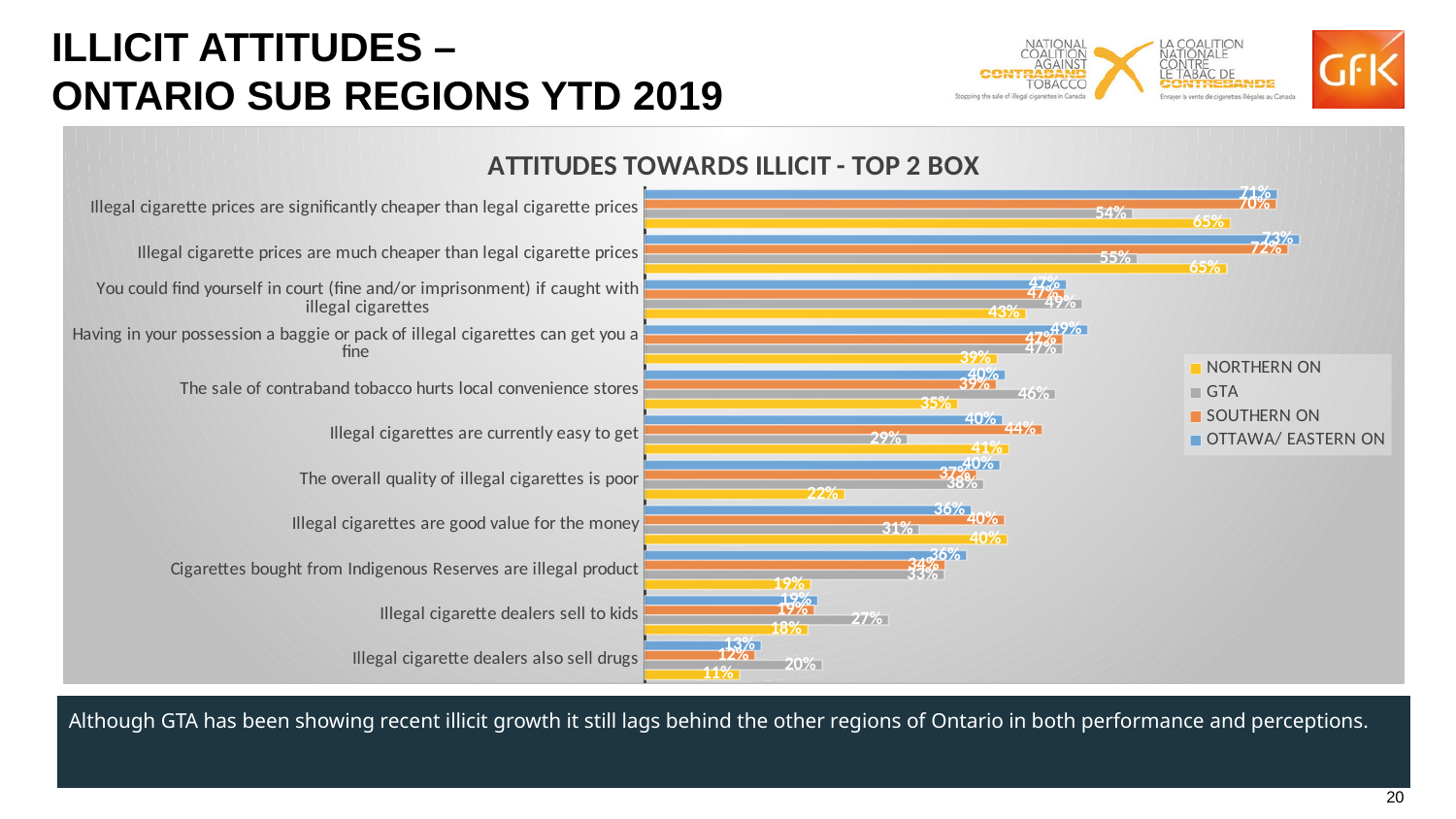
Which region has the lowest value for 'Illegal cigarette dealers also sell drugs'? NORTHERN ON How many attitude statements (categories) are plotted in the chart? 11 What is the Northern ON value for 'The overall quality of illegal cigarettes is poor'? 22% What type of chart is shown on the slide? bar chart How many series does the legend list? 4 What is the GTA value for 'Illegal cigarettes are currently easy to get'? 29% Which region has the highest value for 'The sale of contraband tobacco hurts local convenience stores'? GTA What is the GTA value for 'Illegal cigarette dealers sell to kids'? 27% For 'Illegal cigarettes are good value for the money', which is larger: the GTA value or the Northern ON value? NORTHERN ON What is the GTA value for 'Illegal cigarette prices are significantly cheaper than legal cigarette prices'? 54% What is the difference between the GTA value (20%) and the Northern ON value (11%) for 'Illegal cigarette dealers also sell drugs'? 9% What is the Northern ON value for 'Illegal cigarette prices are much cheaper than legal cigarette prices'? 65%